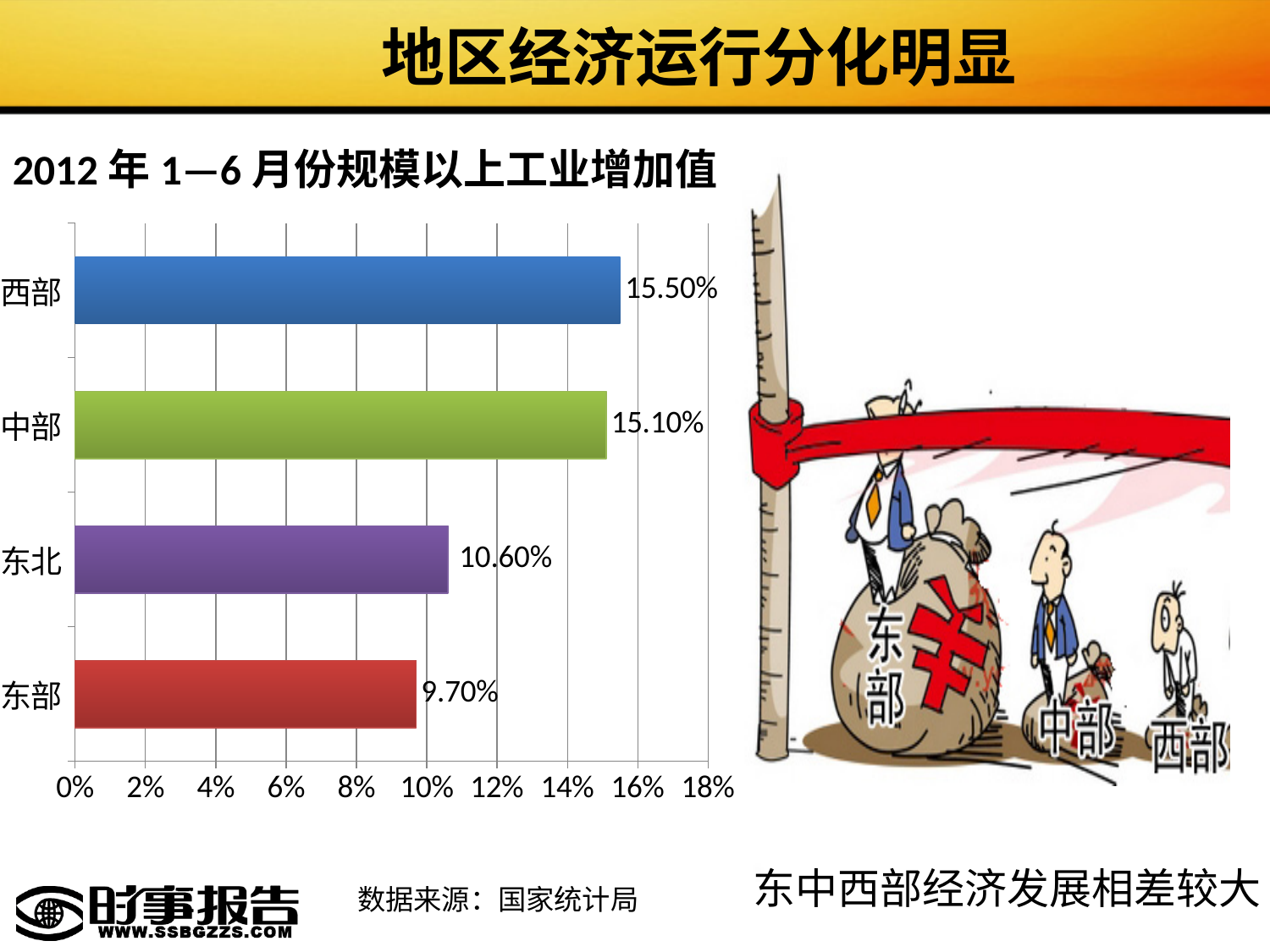
Which region has the lowest value? 东部 What kind of chart is shown on the slide? bar chart Is the value for 中部 greater or less than 14%? greater What is the difference between the values for 中部 and 东北? 4.50% How many regions are shown in the chart? 4 What is the value for 东北? 10.60% Which region has the highest value? 西部 What is the difference between the values for 西部 and 东部? 5.80% Which is larger, the value for 东北 or the value for 东部? 东北 What is the value for 东部? 9.70% What is the value for 西部? 15.50% What is the title of the chart? 2012年1—6月份规模以上工业增加值